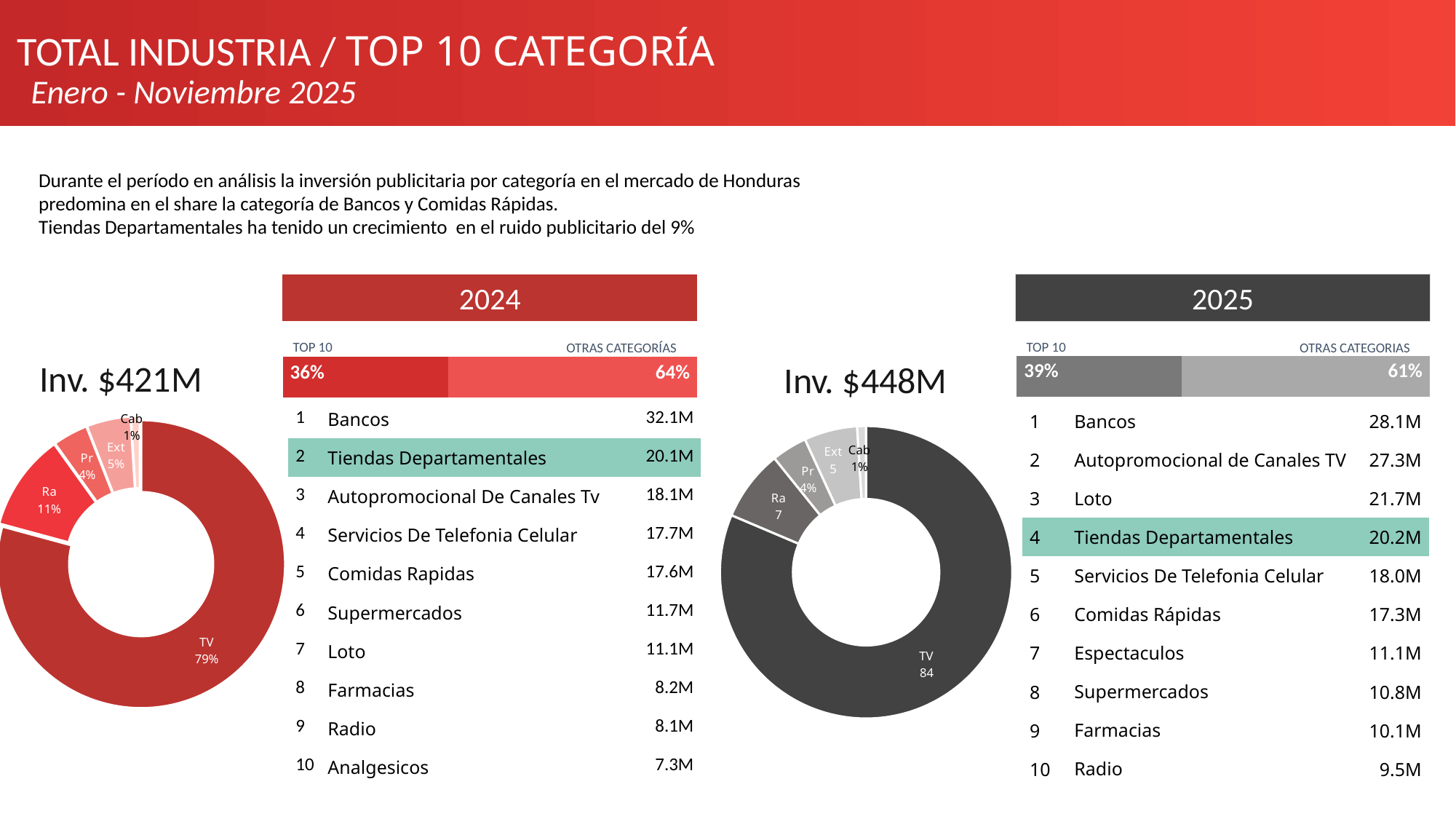
By how many percentage points does the TV share in the 2025 pie chart exceed the TV share in the 2024 pie chart? 5 What kind of chart is shown under "Inv. $421M" on the left of the slide? doughnut chart In the 2024 stacked bar, what share is shown for TOP 10? 36% How many slices does the 2024 pie chart (under Inv. $421M) have? 5 In the 2024 pie chart (under Inv. $421M), which slice is the largest? TV Is the TV share larger in the 2024 pie chart or in the 2025 pie chart? 2025 In the 2025 stacked bar, what share is shown for OTRAS CATEGORIAS? 61% In the 2024 pie chart (under Inv. $421M), what share does Ra have? 11% In the 2025 pie chart (under Inv. $448M), what value is shown for TV? 84 In the 2024 pie chart (under Inv. $421M), which slice is the smallest? Cab In the 2024 pie chart (under Inv. $421M), what share does TV have? 79% In the 2025 pie chart (under Inv. $448M), what value is shown for Ra? 7